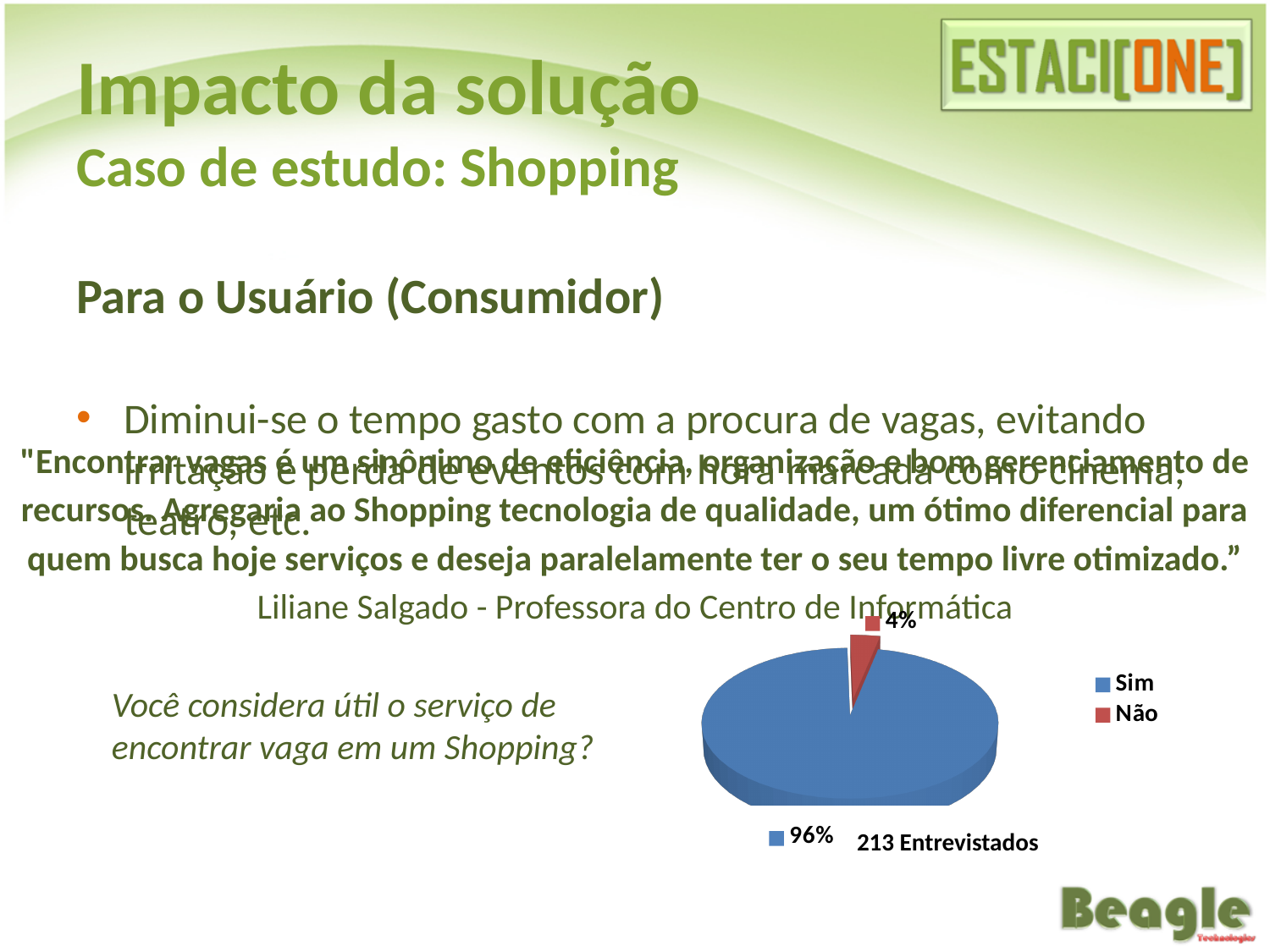
How many entries does the legend of the pie chart list? 2 What share of the pie does the "Sim" slice represent? 96% What is the difference in percentage points between the "Sim" and "Não" slices? 92 What kind of chart is shown on the slide? pie chart Which is larger in the pie chart, "Sim" or "Não"? Sim What colour is the "Sim" slice in the pie chart? blue Which slice of the pie chart is the smallest? Não How many respondents (entrevistados) does the pie chart note below it? 213 Entrevistados What share of the pie does the "Não" slice represent? 4% How many slices does the pie chart have? 2 Which slice of the pie chart is the largest? Sim